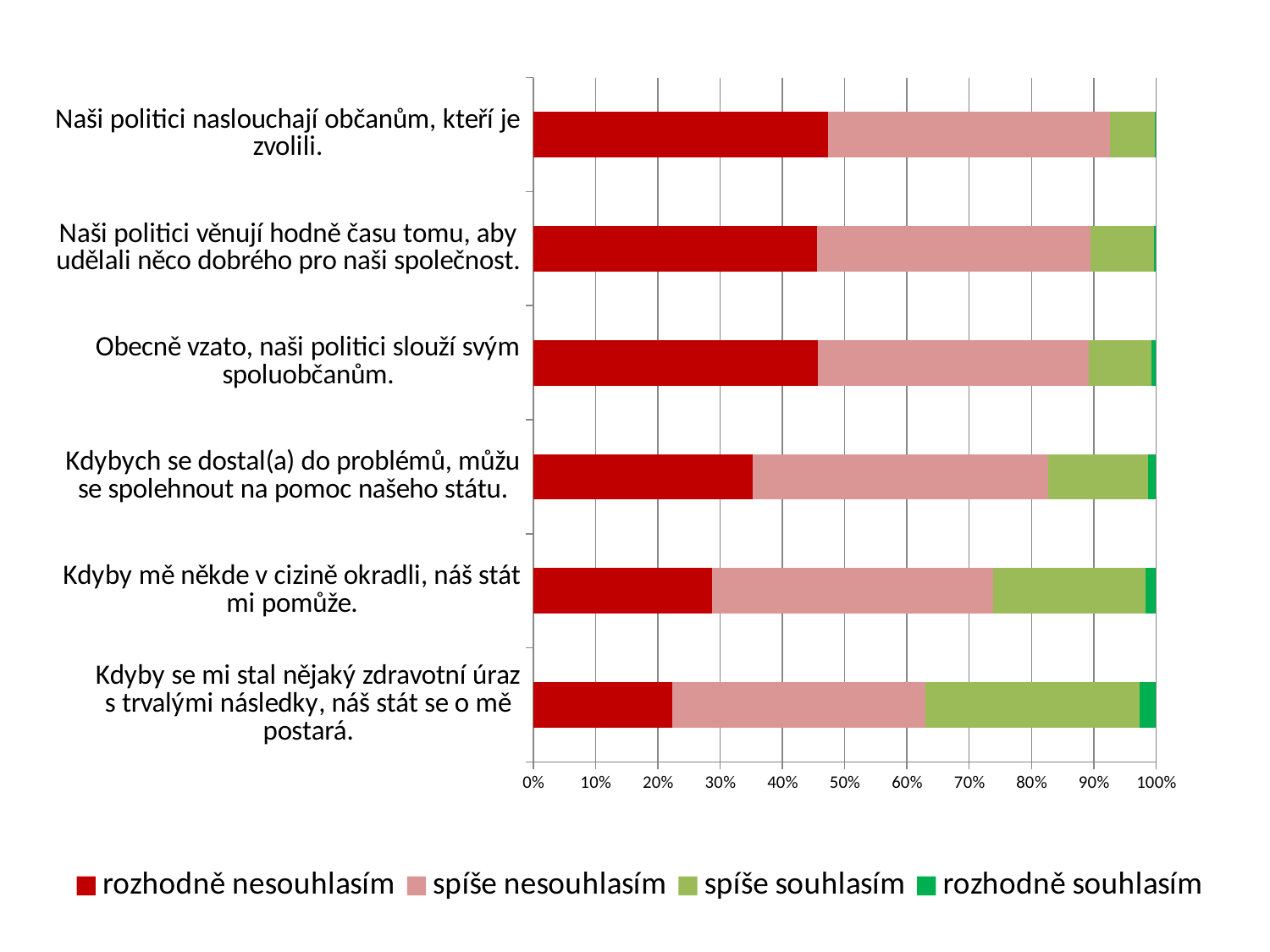
Which has the larger 'rozhodně nesouhlasím' share: 'Kdybych se dostal(a) do problémů, můžu se spolehnout na pomoc našeho státu.' or 'Kdyby mě někde v cizině okradli, náš stát mi pomůže.'? Kdybych se dostal(a) do problémů, můžu se spolehnout na pomoc našeho státu. Is the 'rozhodně nesouhlasím' share for 'Kdyby mě někde v cizině okradli, náš stát mi pomůže.' greater or less than 40%? less How many series does the legend list? 4 Going from the top bar to the bottom bar, does the 'rozhodně nesouhlasím' share increase or decrease? decrease What kind of chart is shown on the slide? Stacked bar chart Is the 'rozhodně nesouhlasím' share for 'Naši politici naslouchají občanům, kteří je zvolili.' greater or less than 40%? greater Which statement has the largest 'spíše souhlasím' share? Kdyby se mi stal nějaký zdravotní úraz s trvalými následky, náš stát se o mě postará. How many statements (categories) are plotted in the chart? 6 What is the last entry in the chart legend? rozhodně souhlasím Is the 'rozhodně nesouhlasím' share for 'Kdyby se mi stal nějaký zdravotní úraz s trvalými následky, náš stát se o mě postará.' greater or less than 30%? less Which statement has the smallest 'rozhodně nesouhlasím' share? Kdyby se mi stal nějaký zdravotní úraz s trvalými následky, náš stát se o mě postará. Which series is shown in dark red in the legend? rozhodně nesouhlasím